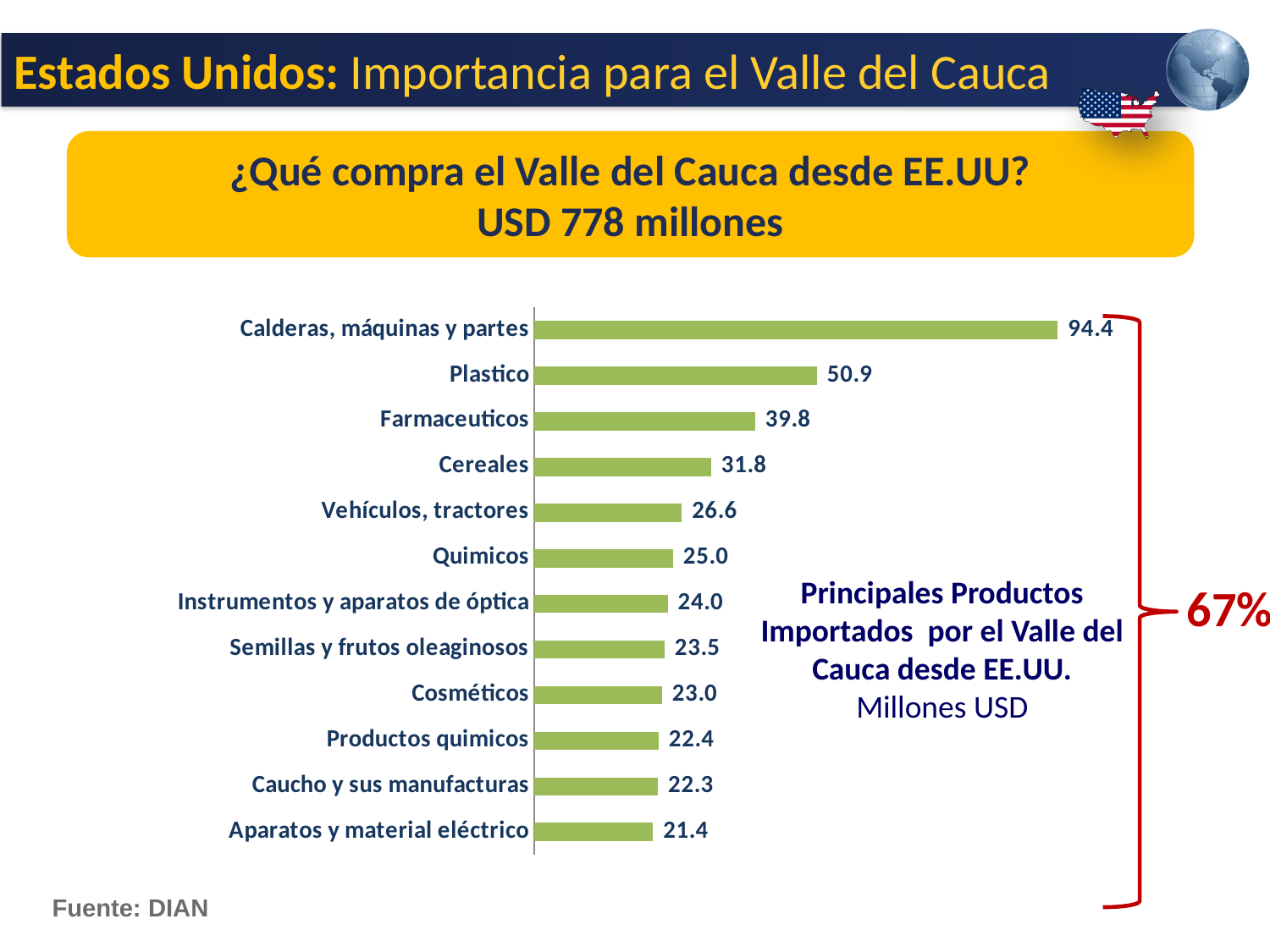
What kind of chart is shown on the slide? Bar chart How many categories are shown in the chart? 12 What is the value for Aparatos y material eléctrico? 21.4 What is the value for Plastico? 50.9 What is the value for Calderas, máquinas y partes? 94.4 What is the value for Cereales? 31.8 Which category has the lowest value? Aparatos y material eléctrico Which category has the highest value? Calderas, máquinas y partes What is the difference between the values for Farmaceuticos and Cereales? 8.0 What unit is stated for the values in the chart? Millones USD Which is larger, the value for Vehículos, tractores or the value for Quimicos? Vehículos, tractores What is the difference between the values for Calderas, máquinas y partes and Plastico? 43.5